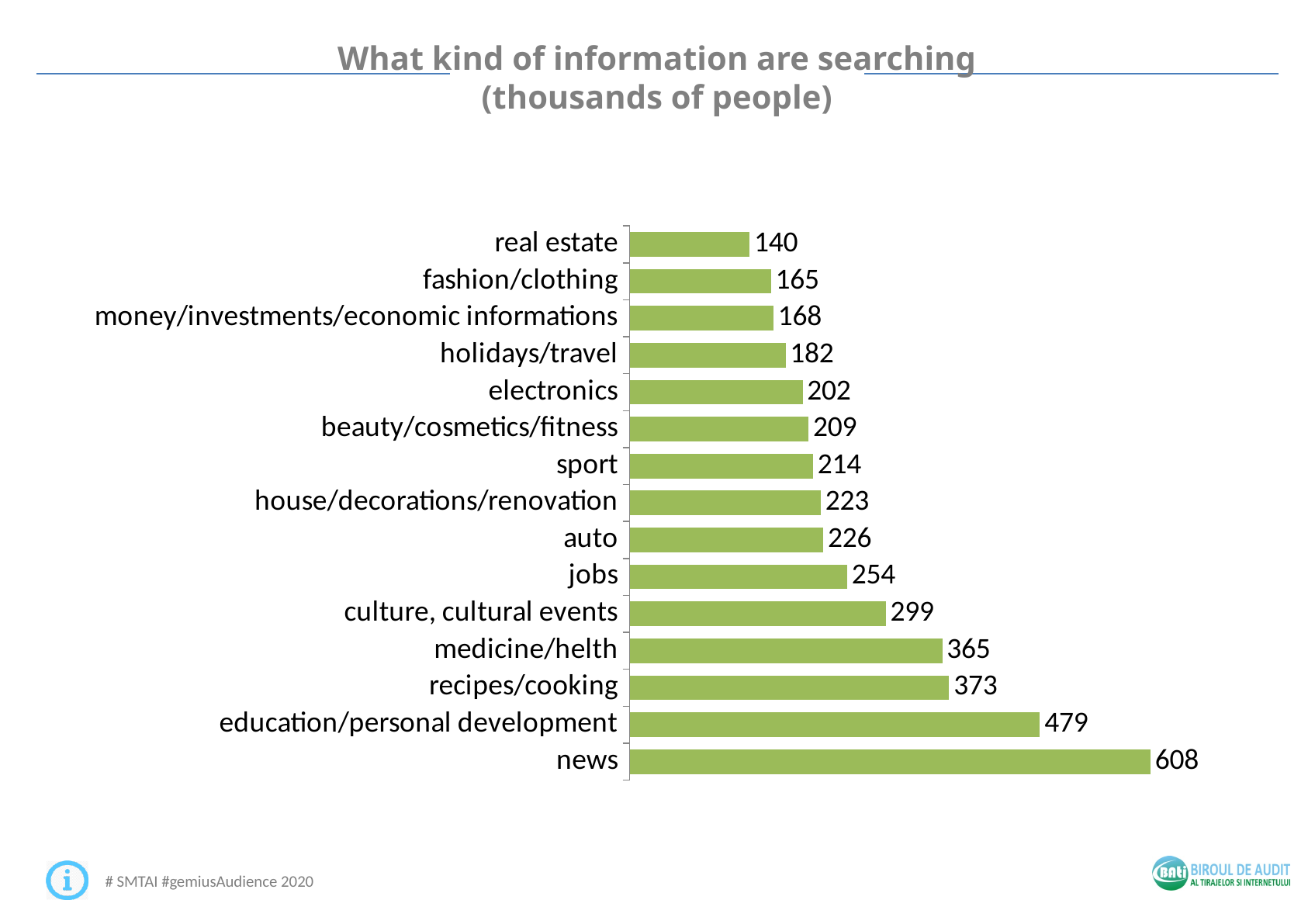
What is the value for recipes/cooking? 373 Which category has the lowest value? real estate What kind of chart is shown on the slide? bar chart Which is larger, the value for medicine/helth or the value for culture, cultural events? medicine/helth What is the value for holidays/travel? 182 What is the difference between the values for news and education/personal development? 129 What is the value for news? 608 Which category has the highest value? news Which is larger, the value for electronics or the value for auto? auto What is the title of the chart? What kind of information are searching (thousands of people) How many categories are shown in the chart? 15 What is the difference between the values for jobs and real estate? 114